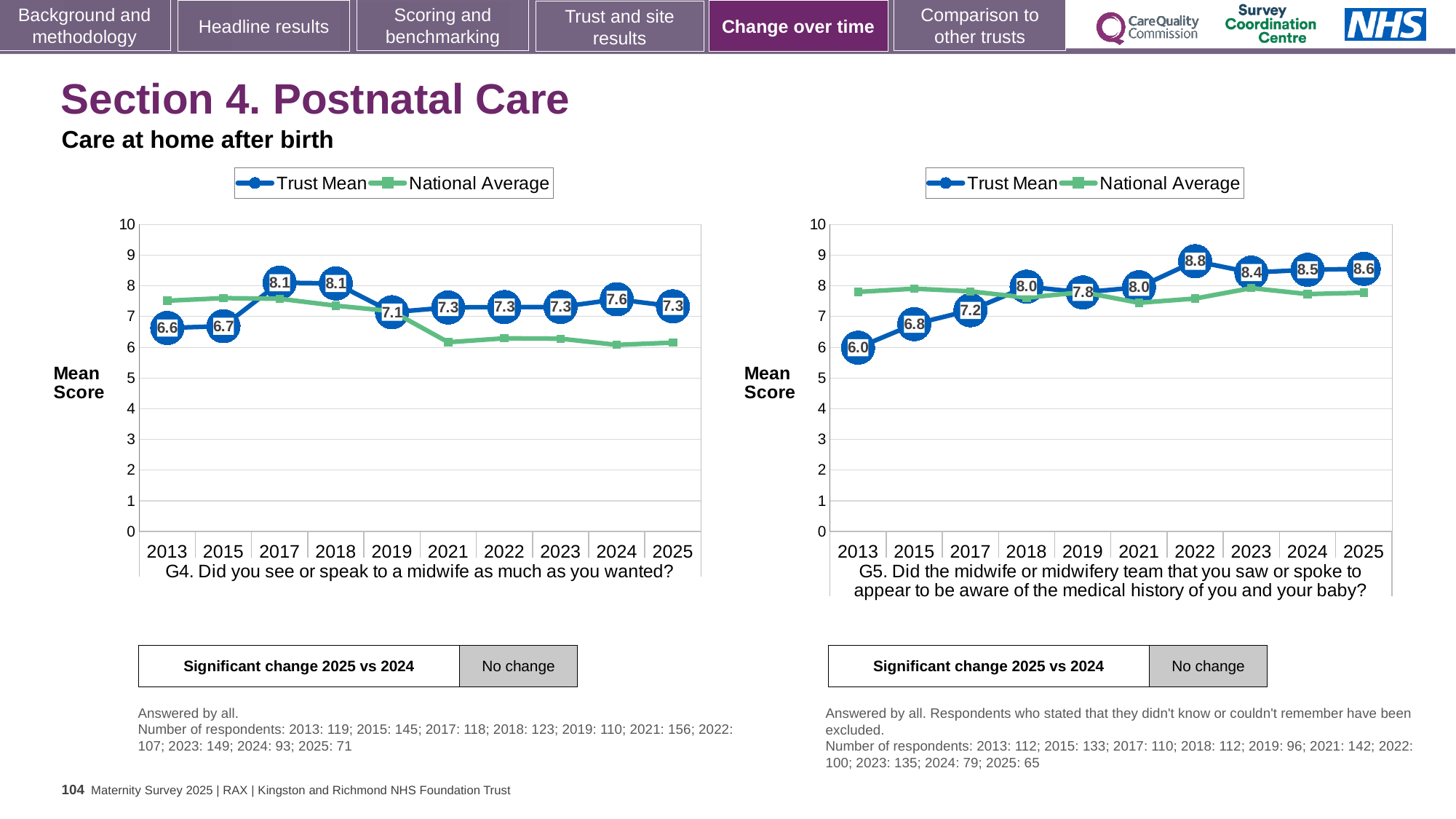
In the G5 chart (right), which year has the highest Trust Mean? 2022 In the G4 chart (left), which is larger: the Trust Mean for 2017 or the Trust Mean for 2019? 2017 In the G4 chart (left), what is the Trust Mean for 2025? 7.3 In the G4 chart (left), which year has the lowest Trust Mean? 2013 In the G5 chart (right), does the Trust Mean rise or fall from 2013 to 2018? Rise What kind of chart is the G4 chart (left)? Line chart How many years are shown on the x axis of the G4 chart (left)? 10 In the G5 chart (right), what is the difference between the Trust Mean for 2022 and the Trust Mean for 2013? 2.8 In the G5 chart (right), is the National Average for 2013 greater or less than 7? greater In the G5 chart (right), what is the Trust Mean for 2013? 6.0 In the G4 chart (left), is the National Average for 2025 greater or less than 7? less How many series does the legend of the G5 chart (right) list? 2